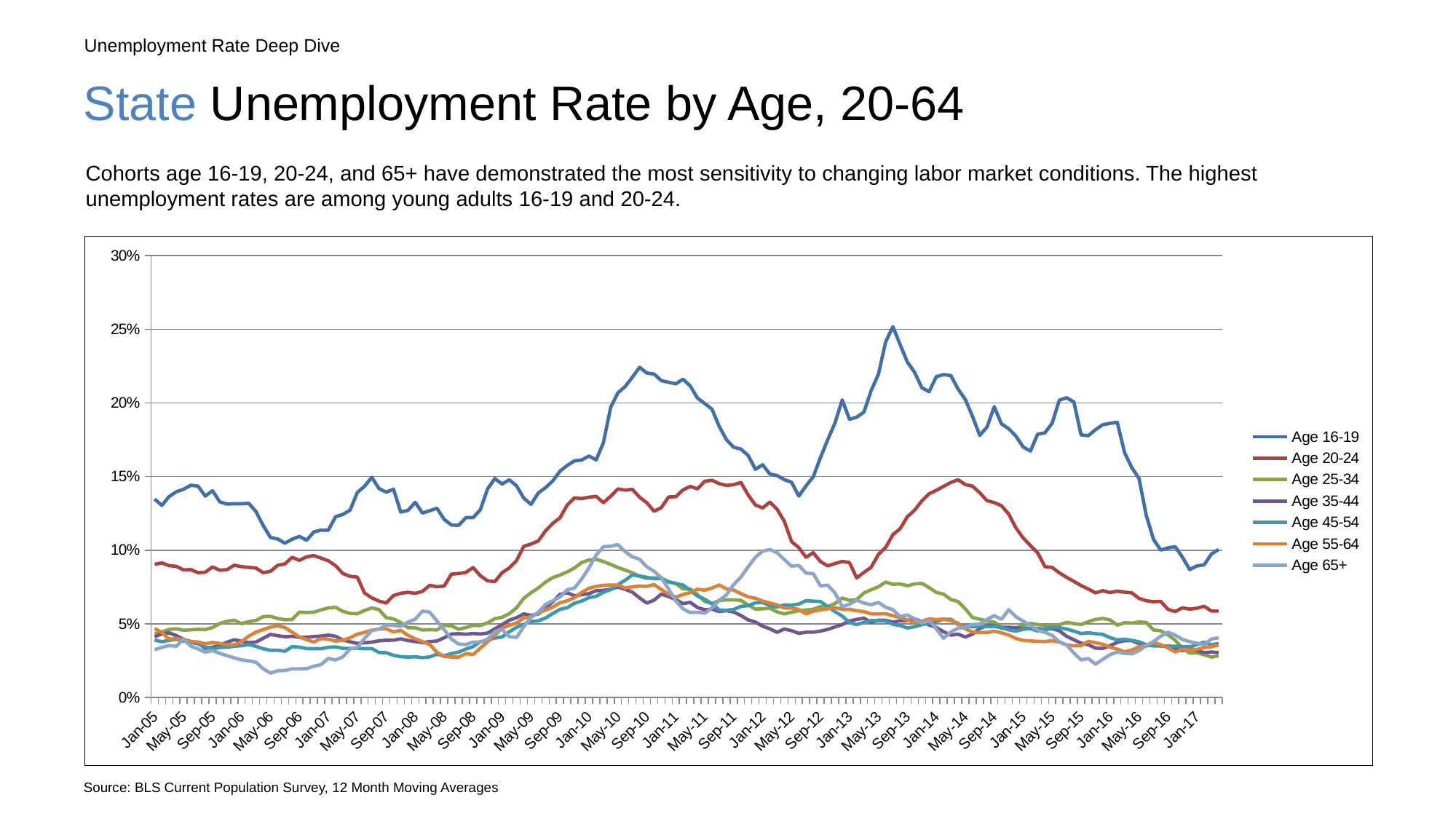
Is the value for Age 16-19 at Sep-13 greater or less than 20%? greater At Jan-13, which is larger: the value for Age 16-19 or the value for Age 20-24? Age 16-19 How many series does the legend list? 7 Is the value for Age 65+ at Jan-12 greater or less than 5%? greater Which age group reaches the highest unemployment rate at any point in the chart? Age 16-19 What kind of chart is shown on the slide? line chart Is the value for Age 16-19 at Jan-05 greater or less than 10%? greater Does the Age 16-19 line rise or fall between Jan-16 and Jan-17? fall Which age group has the lowest unemployment rate at May-06? Age 65+ What is the highest value shown on the vertical axis? 30%